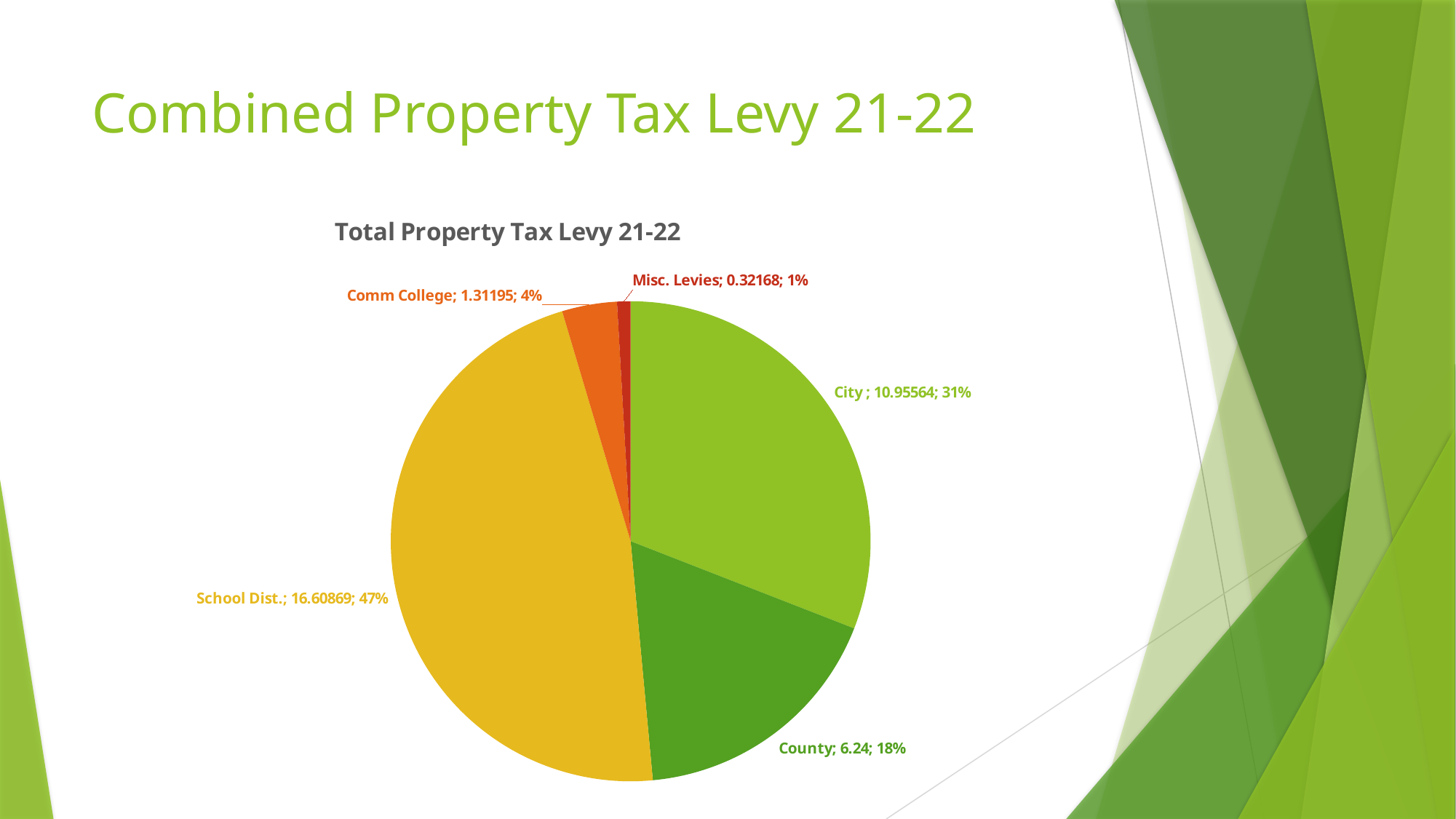
Which is larger, the value for County or the value for Comm College? County What is the value for Comm College? 1.31195 What is the value for School Dist.? 16.60869 What type of chart is shown on the slide? pie chart What is the title of the chart? Total Property Tax Levy 21-22 How many slices does the pie chart have? 5 What is the value for County? 6.24 Which category has the smallest slice? Misc. Levies What share of the pie does City represent? 31% What is the value for City? 10.95564 Which category has the largest slice? School Dist. What is the value for Misc. Levies? 0.32168